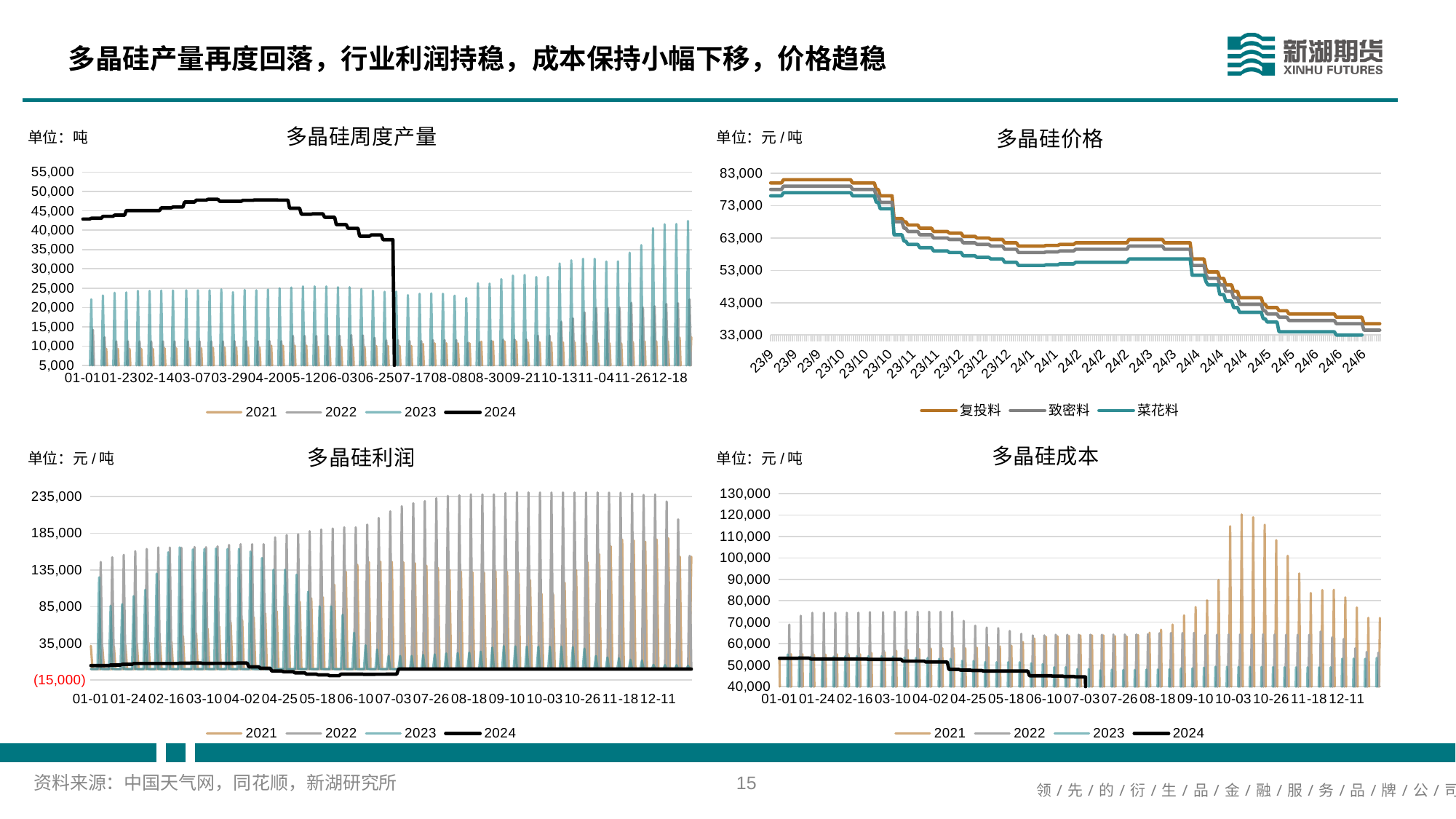
In the 多晶硅价格 chart, is the value of 菜花料 at 24/6 greater or less than 43,000? less How many series does the legend of the 多晶硅价格 chart list? 3 In the 多晶硅成本 chart, is the 2024 value at 01-01 greater or less than 60,000? less In the 多晶硅成本 chart, does the 2024 line rise or fall from 01-01 to 07-03? fall What are the legend entries of the 多晶硅价格 chart? 复投料, 致密料, 菜花料 In the 多晶硅价格 chart, does the 复投料 line rise or fall from 23/9 to 24/6? fall In the 多晶硅利润 chart, is the 2024 value at 01-01 greater or less than 35,000? less In the 多晶硅价格 chart, which series is higher at 23/9, 复投料 or 菜花料? 复投料 How many charts are shown on the slide? 4 How many series does the legend of the 多晶硅周度产量 chart list? 4 What kind of chart is the 多晶硅价格 chart? line chart